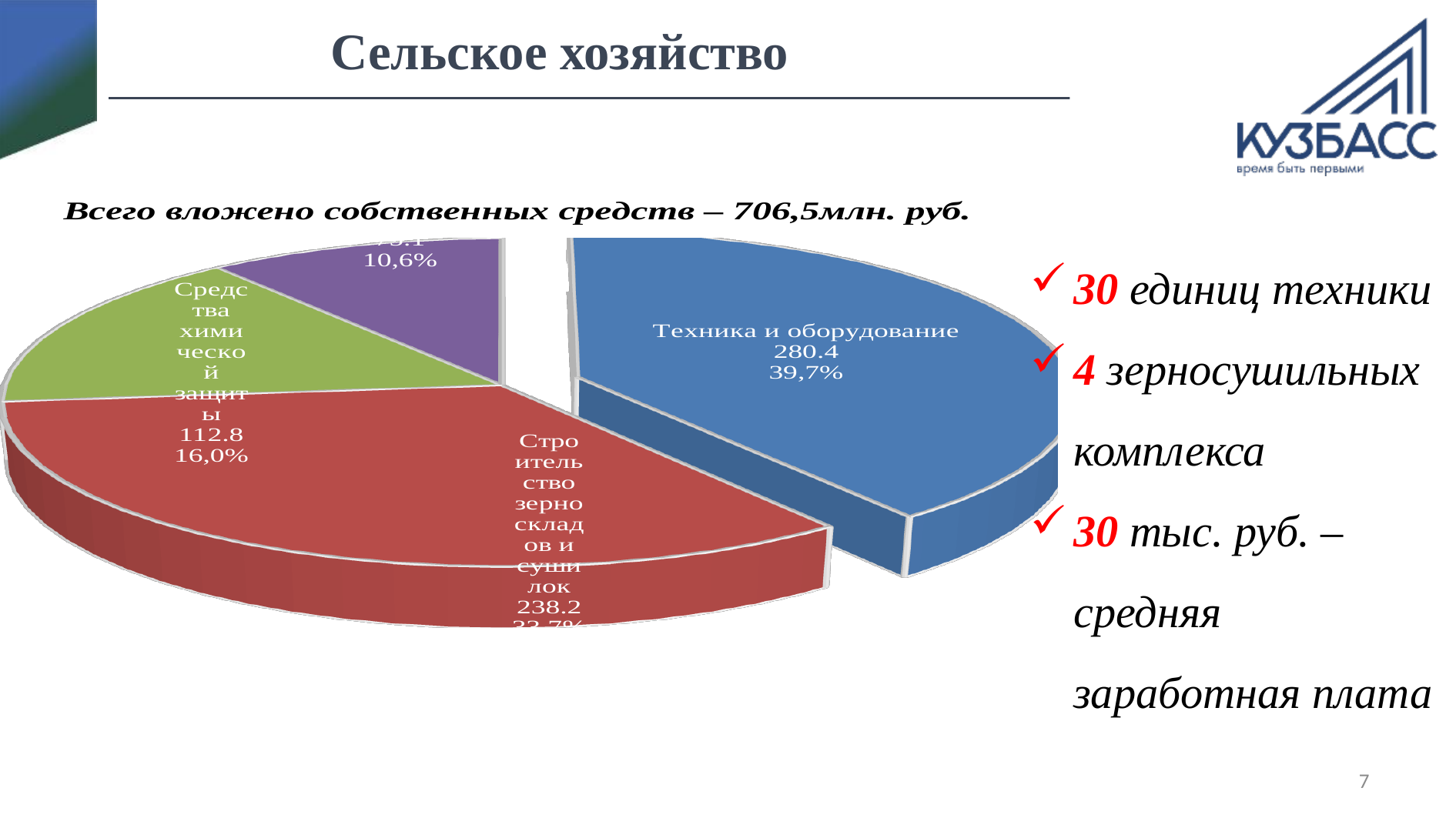
How many slices does the pie chart have? 4 What colour is the slice for Техника и оборудование? blue What share of the pie does Техника и оборудование take? 39,7% What share of the pie does the smallest slice take? 10,6% Which category has the largest slice of the pie? Техника и оборудование What is the difference between the values for Техника и оборудование and Средства химической защиты? 167.6 What kind of chart is shown on the slide? pie chart What share of the pie does Средства химической защиты take? 16,0% What is the value shown for Средства химической защиты? 112.8 What is the value shown for Строительство зерноскладов и сушилок? 238.2 Which is larger: Техника и оборудование or Строительство зерноскладов и сушилок? Техника и оборудование What is the value shown for Техника и оборудование? 280.4